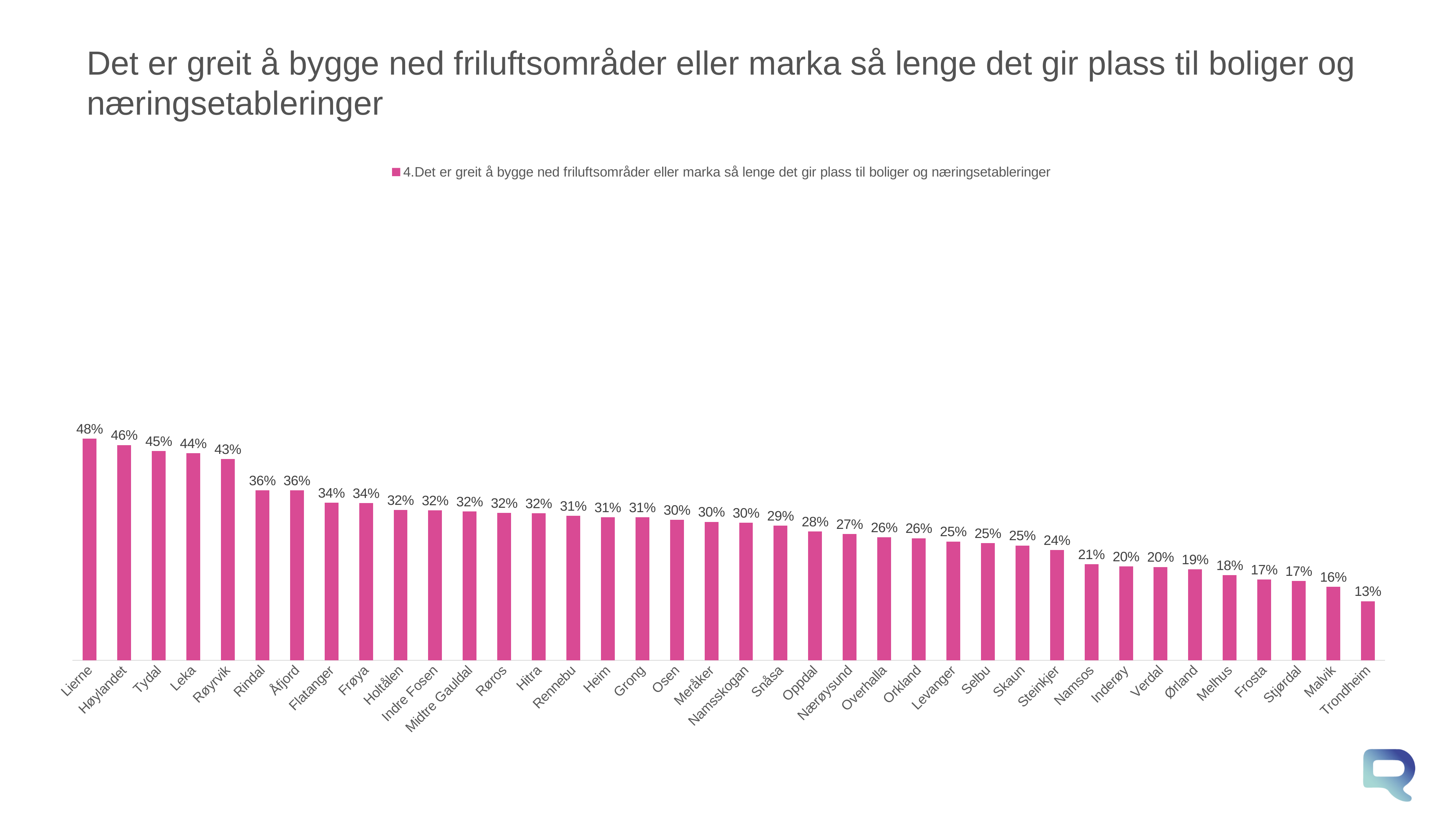
What kind of chart is shown on the slide? Bar chart Which category has the lowest value? Trondheim What is the difference between the values for Røyrvik and Rindal? 7% What is the value for Trondheim? 13% What is the difference between the values for Lierne and Trondheim? 35% Which category has the highest value? Lierne How many categories are shown on the x axis? 38 What is the value for Lierne? 48% Which has a larger value, Tydal or Namsos? Tydal What is the value for Oppdal? 28% Do the values rise or fall from left to right along the x axis? Fall What is the value for Steinkjer? 24%